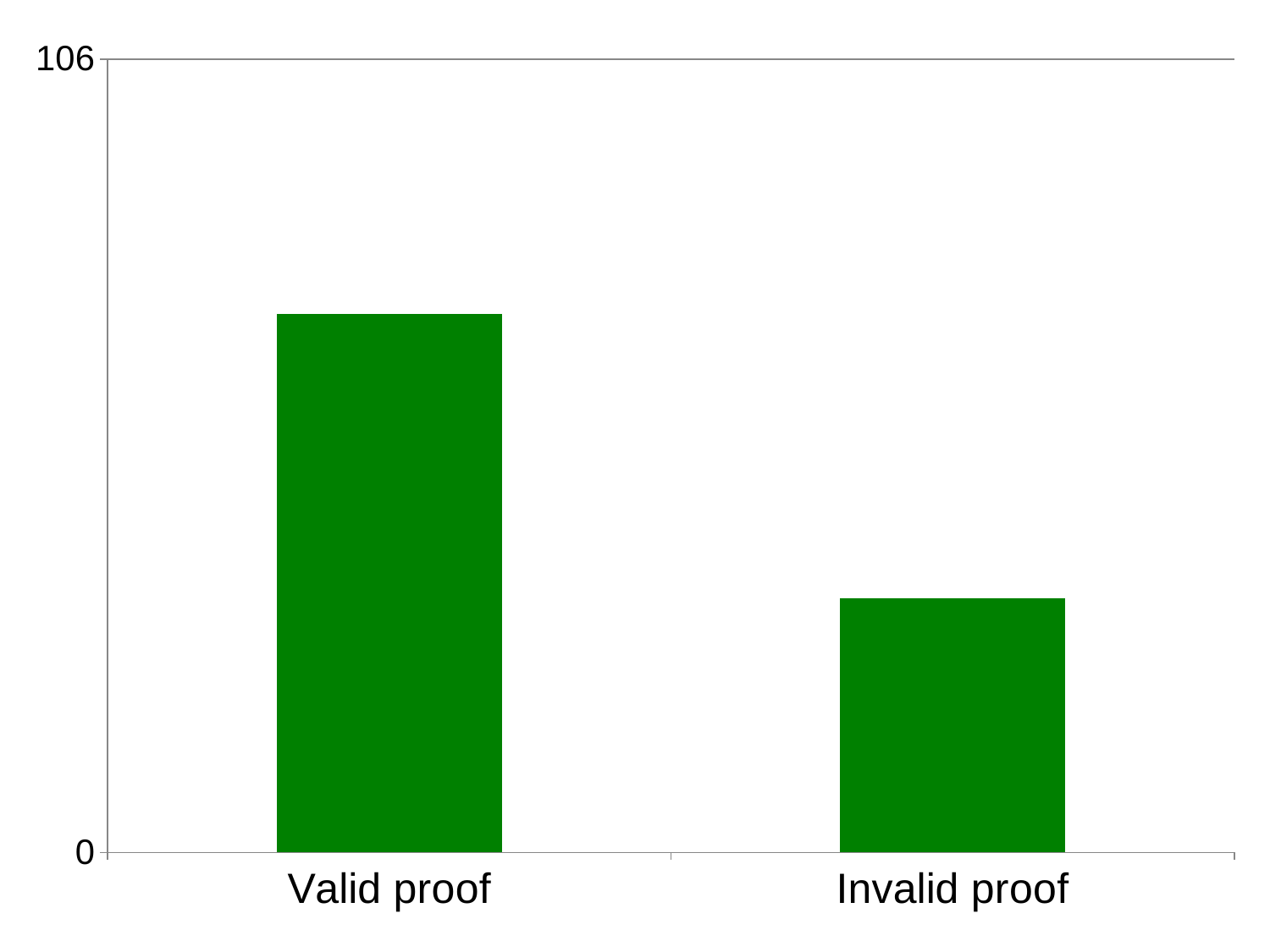
Which category has the lowest bar? Invalid proof Which category has the highest bar? Valid proof What is the highest value labelled on the vertical axis? 106 How many categories are shown on the x axis? 2 Which is larger, the value for Valid proof or the value for Invalid proof? Valid proof Do the values rise or fall from Valid proof to Invalid proof? Fall What kind of chart is shown on the slide? Bar chart What colour are the bars in the chart? Green